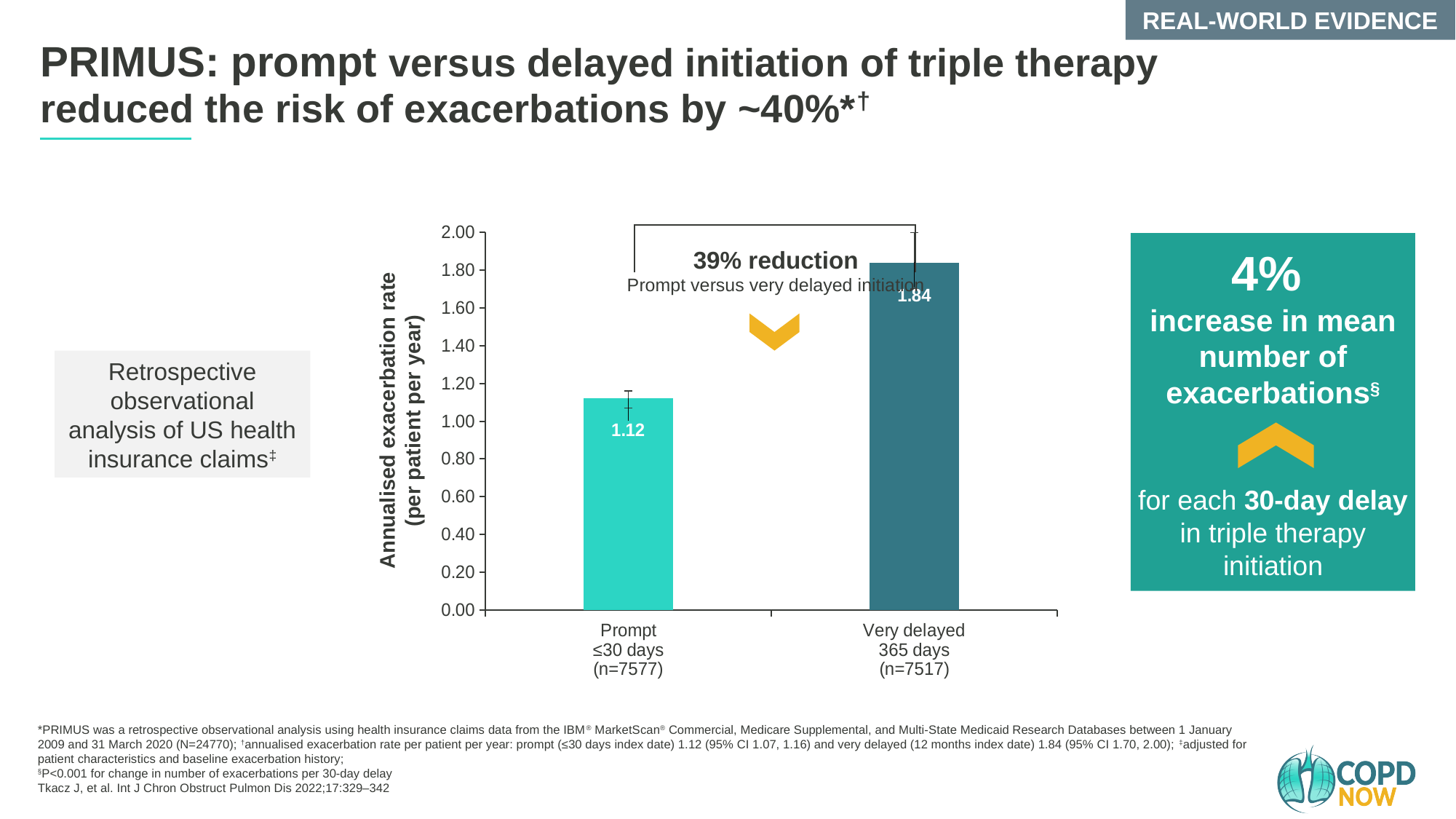
What percentage reduction is annotated on the chart for prompt versus very delayed initiation? 39% reduction What is the annualised exacerbation rate for the Very delayed (365 days) group? 1.84 What is the difference in annualised exacerbation rate between the Very delayed and Prompt groups? 0.72 Is the annualised exacerbation rate for the Prompt group greater or less than 1.20? less What is the annualised exacerbation rate for the Prompt (≤30 days) group? 1.12 Is the annualised exacerbation rate for the Very delayed group greater or less than 1.60? greater What is the label of the y-axis of the chart? Annualised exacerbation rate (per patient per year) Which group has the higher annualised exacerbation rate? Very delayed (365 days) What type of chart is shown on the slide? Bar chart Which group has the lower annualised exacerbation rate? Prompt (≤30 days) How many groups are plotted in the chart? 2 What is the maximum value shown on the y-axis? 2.00